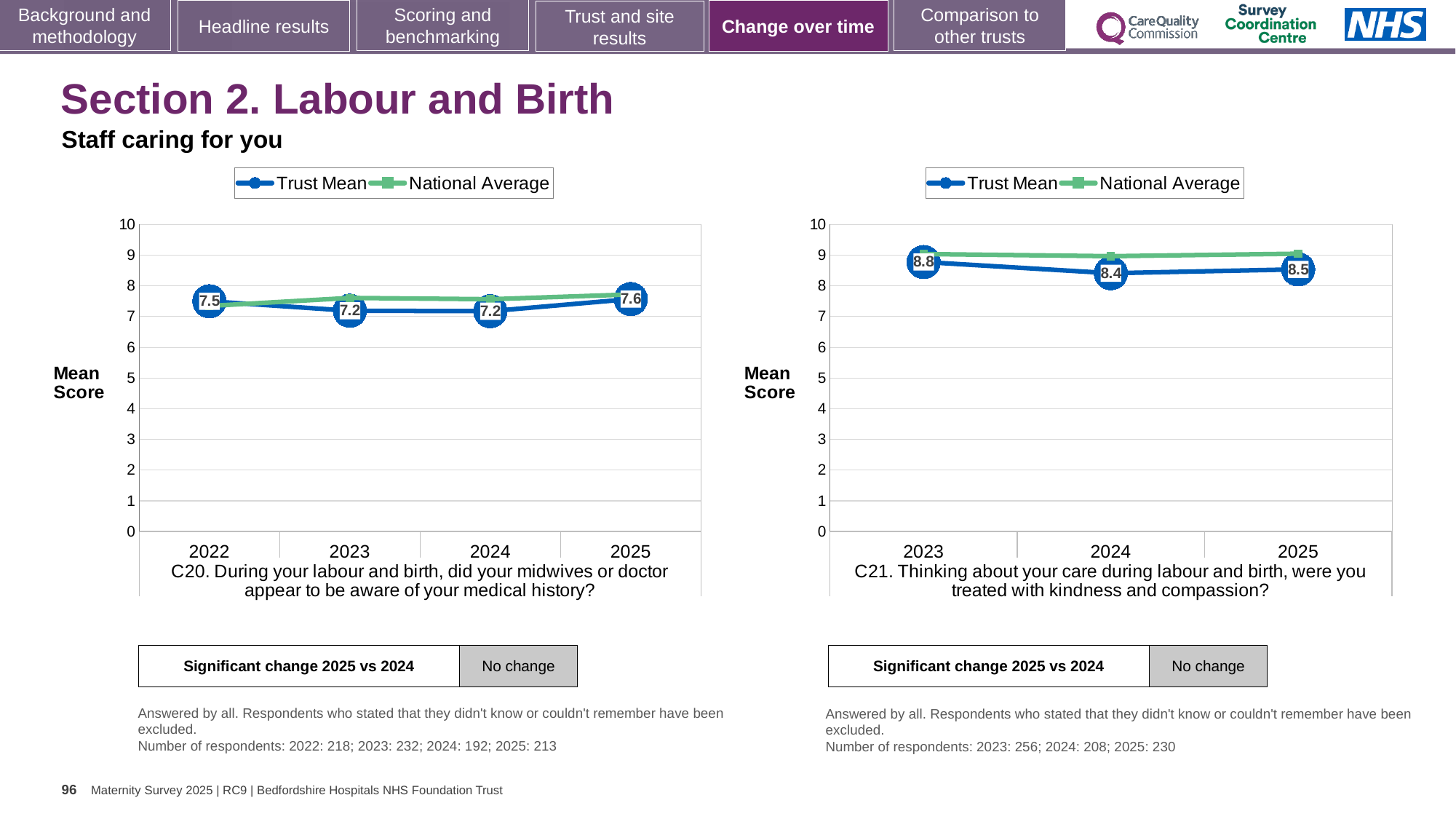
In the C21 chart (right), which year has the lowest Trust Mean score? 2024 In the C21 chart (right), what is the Trust Mean score for 2024? 8.4 In the C21 chart (right), what is the difference between the Trust Mean scores for 2023 and 2024? 0.4 In the C20 chart (left), what is the difference between the Trust Mean scores for 2025 and 2023? 0.4 In the C20 chart (left), what is the Trust Mean score for 2025? 7.6 In the C20 chart (left), what is the Trust Mean score for 2022? 7.5 What kind of chart is the C20 chart (left)? Line chart In the C21 chart (right), is the Trust Mean score for 2023 greater or less than 8? greater In the C20 chart (left), which year has the highest Trust Mean score? 2025 How many years are shown on the x axis of the C20 chart (left)? 4 In the C21 chart (right), which year has the highest Trust Mean score? 2023 How many series does the legend of the C21 chart (right) list? 2